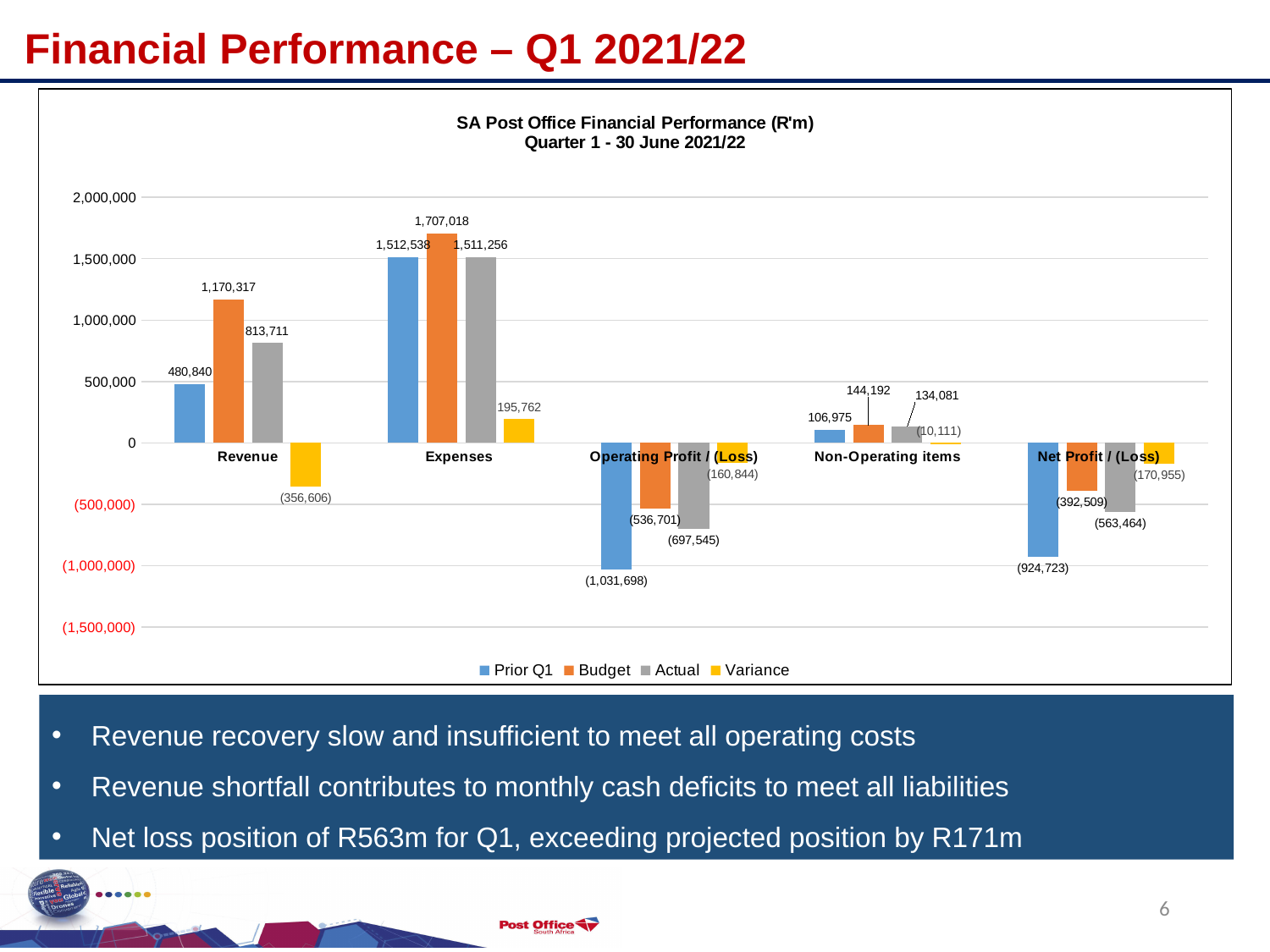
What is the title of the chart? SA Post Office Financial Performance (R'm) Quarter 1 - 30 June 2021/22 What is the Actual value for Revenue? 813,711 What is the Budget value for Expenses? 1,707,018 Which category has the highest Budget value? Expenses How many categories are shown on the x axis? 5 What is the difference between the Budget and Actual values for Revenue? 356,606 How many series does the legend list? 4 What is the Prior Q1 value for Operating Profit / (Loss)? (1,031,698) What is the Actual value for Non-Operating items? 134,081 What is the Variance value for Net Profit / (Loss)? (170,955) What kind of chart is shown on the slide? Bar chart Which is larger for Revenue: the Actual value or the Prior Q1 value? Actual